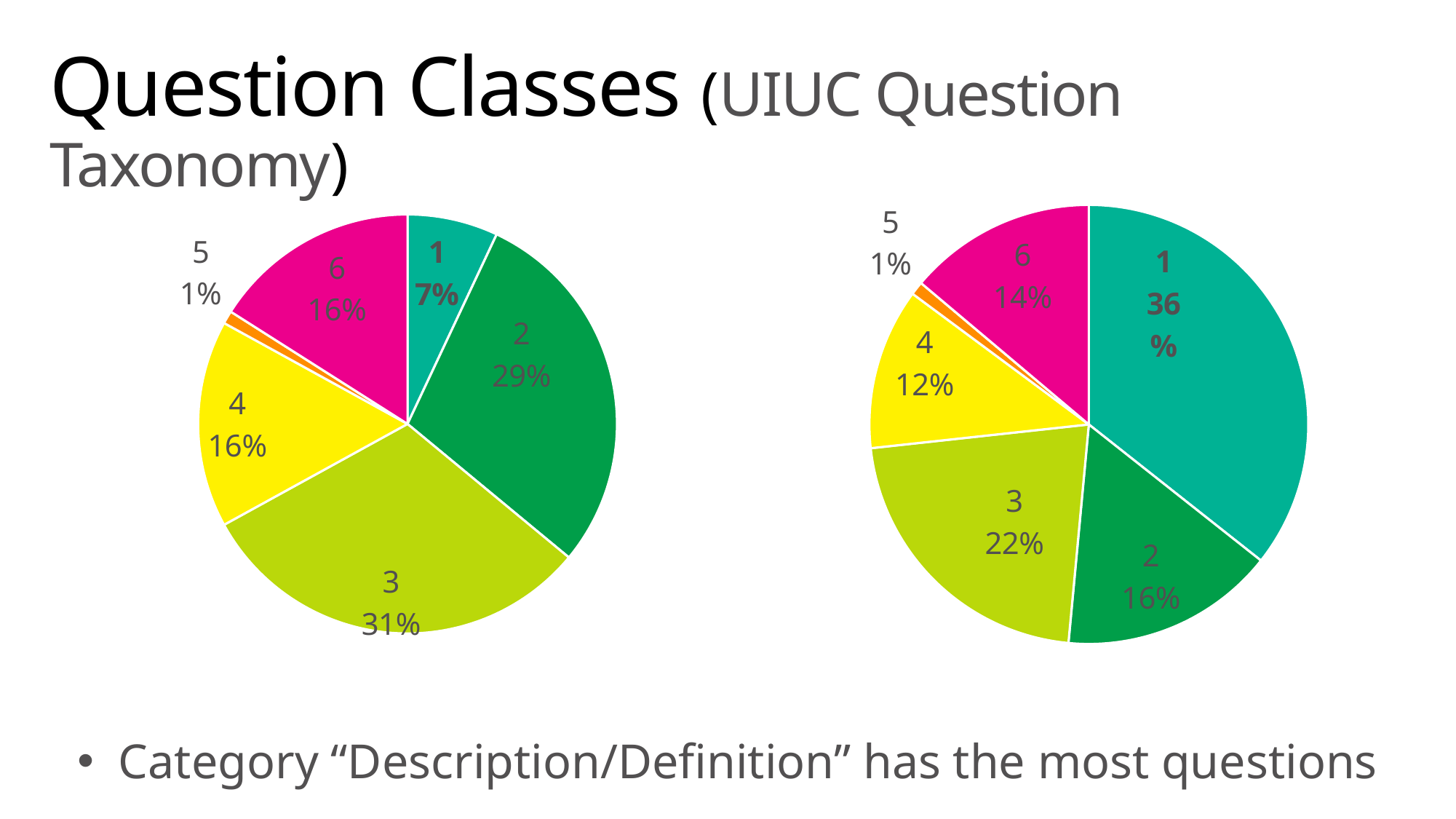
In the right pie chart, which category has the smallest share? 5 In the right pie chart, what share does category 3 have? 22% In the right pie chart, which category has the largest share? 1 How many categories are shown in the left pie chart? 6 In the left pie chart, which category has the largest share? 3 In the left pie chart, which category has the smallest share? 5 In the left pie chart, which has the larger share, category 2 or category 6? 2 In the right pie chart, what is the difference in percentage points between category 1 and category 2? 20 In the left pie chart, what share does category 3 have? 31% In the left pie chart, what share does category 1 have? 7% What type of chart is shown on the right side of the slide? pie chart